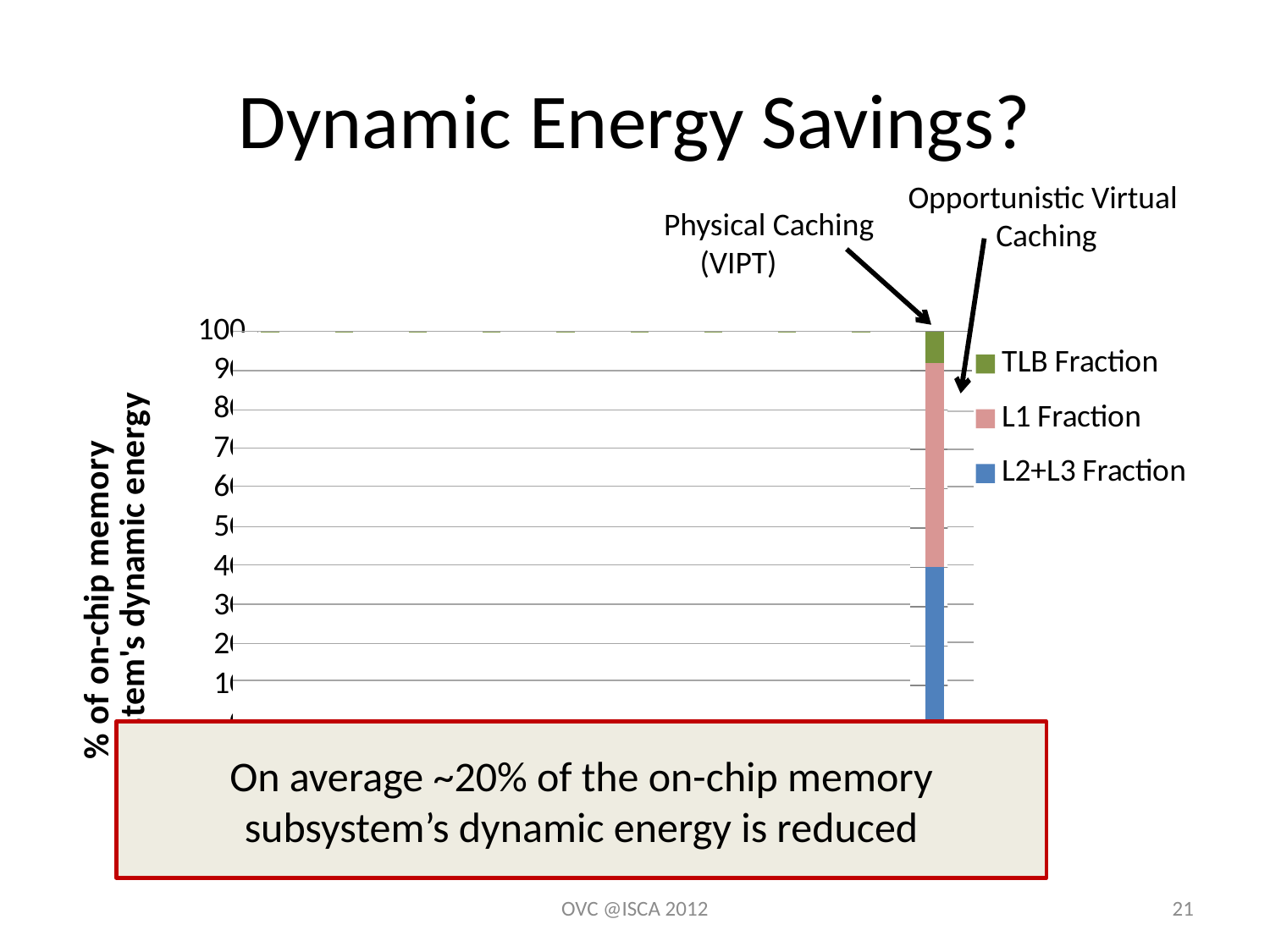
In the Physical Caching (VIPT) bar, which is larger: the L1 Fraction segment or the TLB Fraction segment? L1 Fraction Which colour represents the L2+L3 Fraction series in the chart? Blue Is the L2+L3 Fraction segment of the Physical Caching (VIPT) bar greater or less than 50? less How many series does the chart legend list? 3 What kind of chart is shown on the slide? Stacked bar chart Is the L2+L3 Fraction segment of the Physical Caching (VIPT) bar greater or less than 30? greater What is the total height of the Physical Caching (VIPT) stacked bar? 100 Is the TLB Fraction segment of the Physical Caching (VIPT) bar greater or less than 20? less In the Physical Caching (VIPT) bar, which segment is the largest? L1 Fraction What is the highest value shown on the chart's y axis? 100 Which series are listed in the chart legend? TLB Fraction, L1 Fraction, L2+L3 Fraction In the Physical Caching (VIPT) bar, which segment is the smallest? TLB Fraction